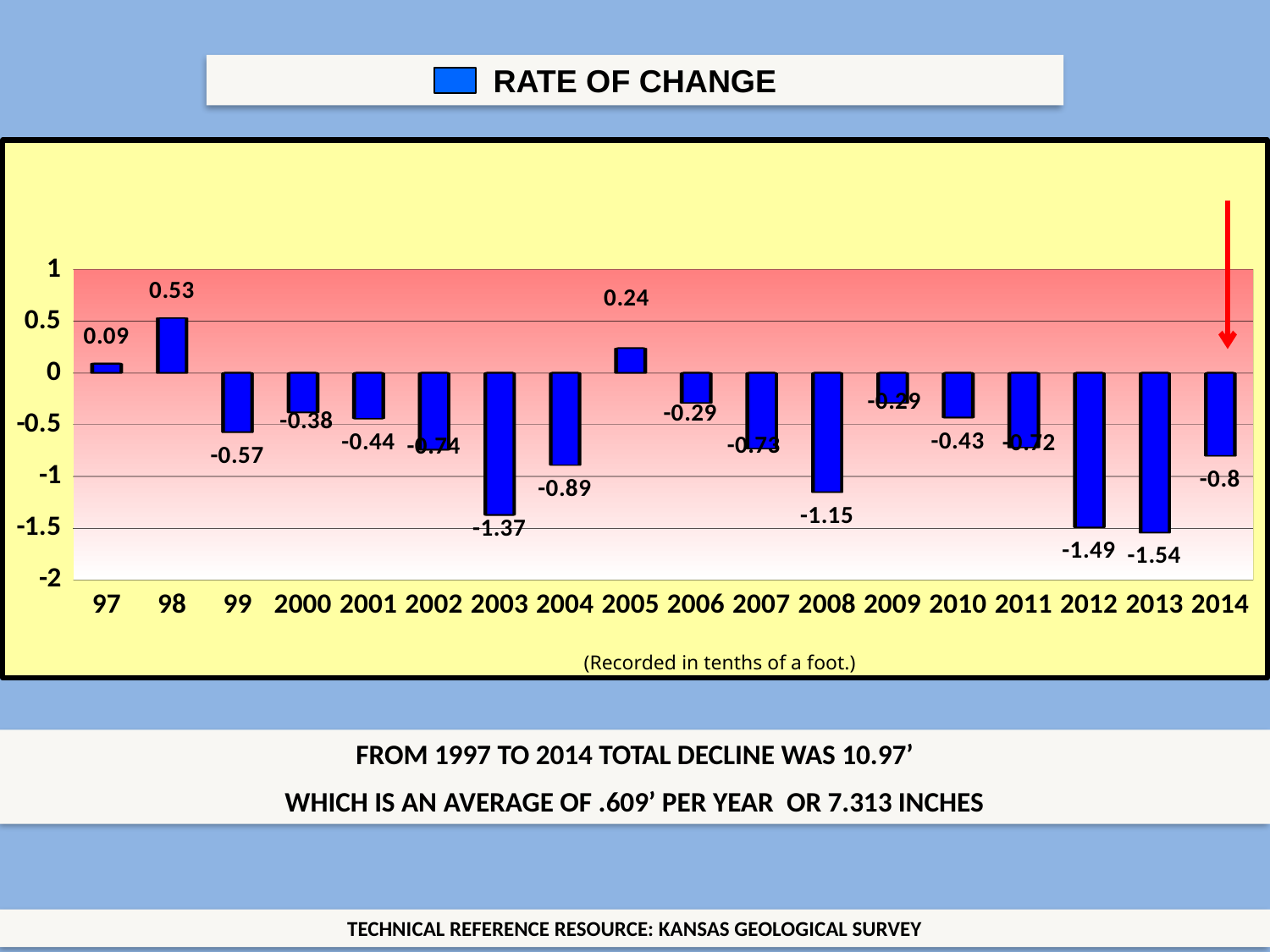
What is the value for 2014? -0.8 Which year has the highest value? 98 What is the value for 98? 0.53 How many years are shown on the x axis? 18 What kind of chart is shown? bar chart What is the value for 2005? 0.24 Is the value for 2008 greater or less than -1? less What is the difference between the values for 2012 and 2013? 0.05 Which year has the lowest value? 2013 What is the legend entry for the plotted series? RATE OF CHANGE What is the value for 2003? -1.37 Which is larger, the value for 2004 or the value for 2003? 2004